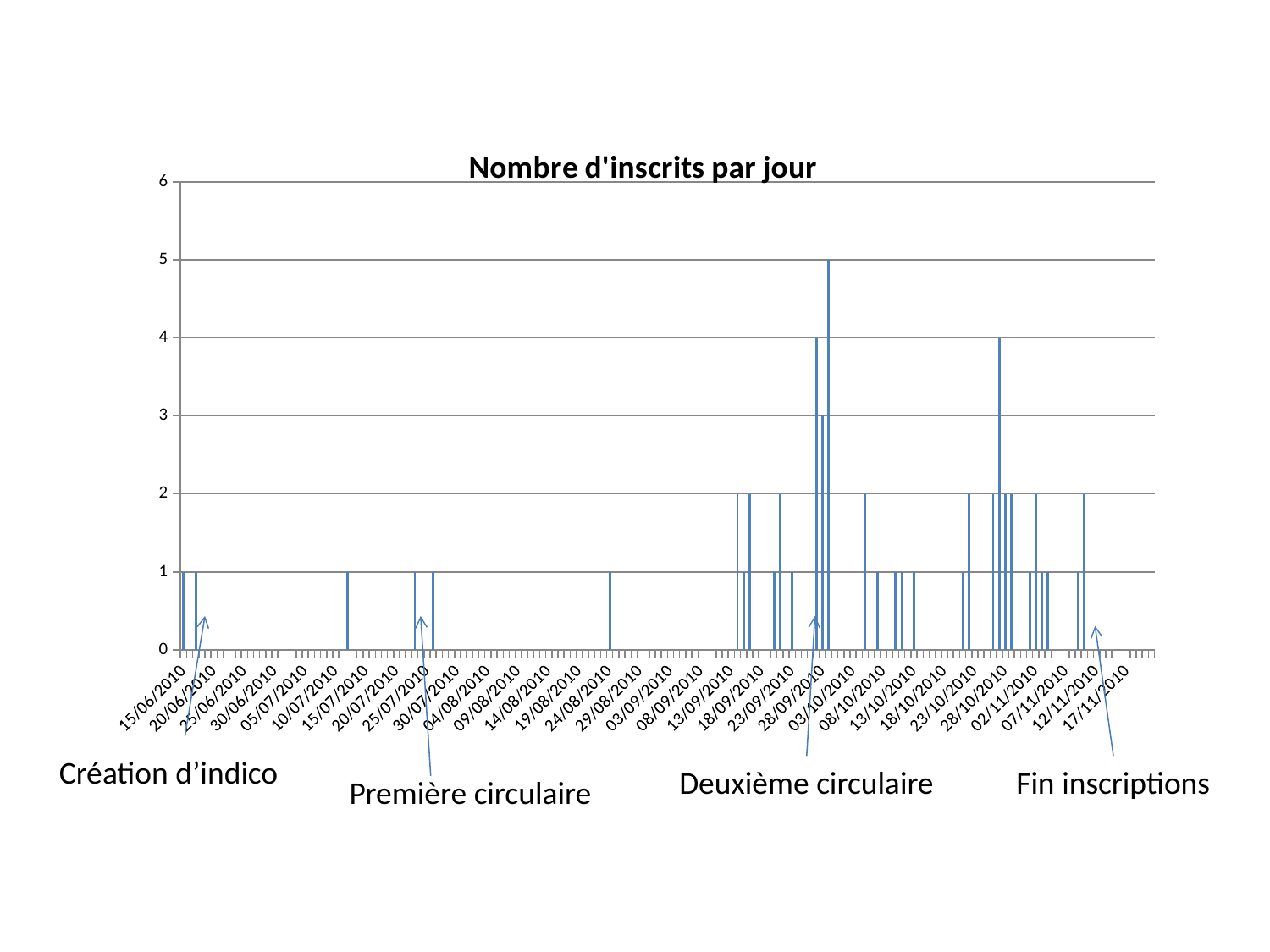
Is the tallest bar in the chart greater or less than 4? greater Is the value of the tallest bar greater or less than 3? greater What kind of chart is shown on the slide? bar chart Does any bar in the chart reach the value 6? No Are there more registrations in the period June–August or in the period September–November? September–November What is the highest value reached by any bar in the chart? 5 Which annotation is placed at the far right of the chart? Fin inscriptions What is the title of the chart? Nombre d'inscrits par jour How many bars in the chart reach a value of 5? 1 How many bars in the chart reach a value of 4? 2